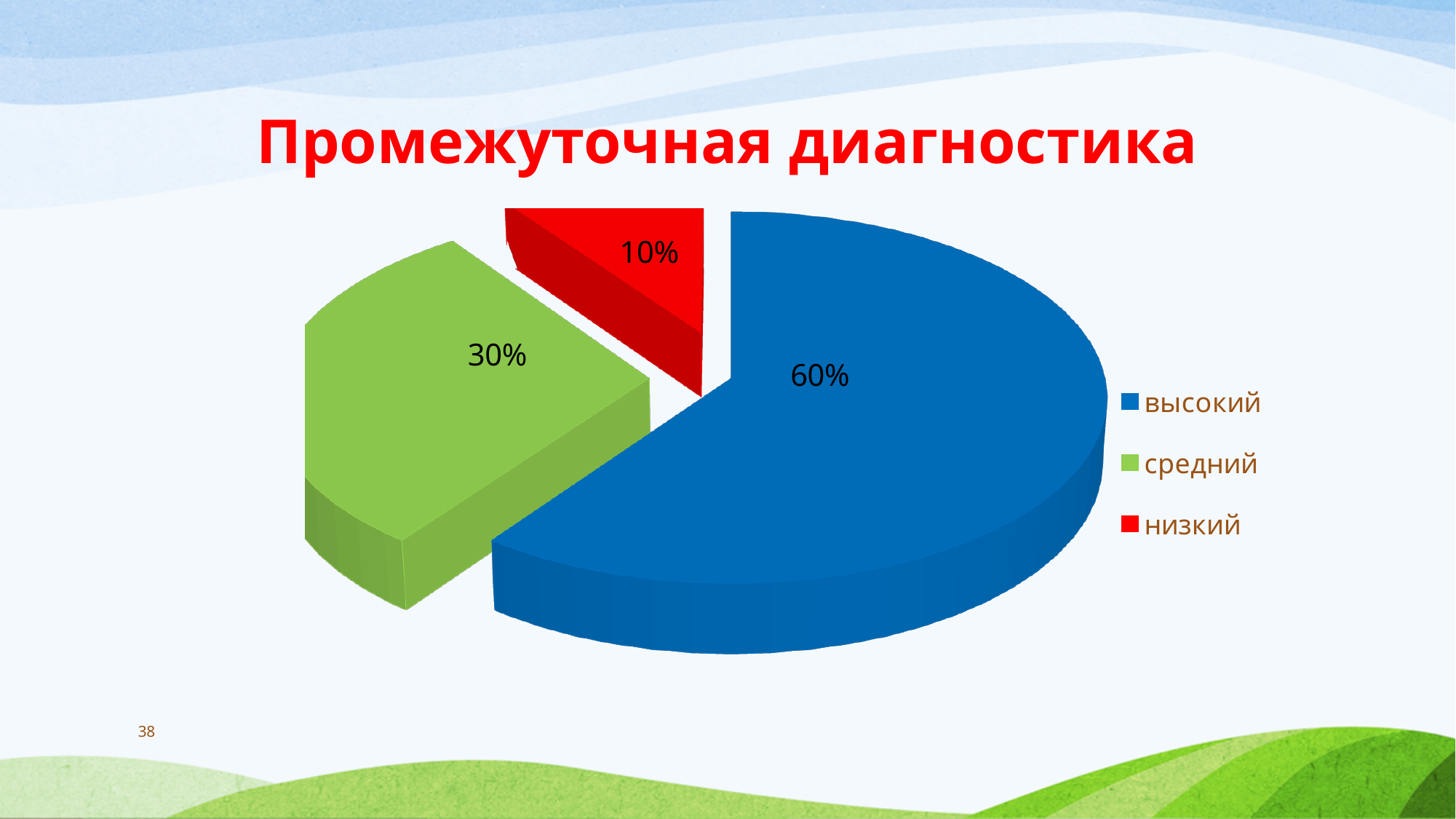
What is the title of the slide containing the chart? Промежуточная диагностика Which category has the smallest share of the pie? низкий How many categories does the pie chart have? 3 What is the difference between the values for средний and низкий? 20% What is the value for высокий? 60% Which is larger, the value for средний or the value for низкий? средний What is the value for средний? 30% What colour is the slice for низкий? red What is the value for низкий? 10% What kind of chart is shown on the slide? pie chart Which category has the largest share of the pie? высокий What is the difference between the values for высокий and средний? 30%